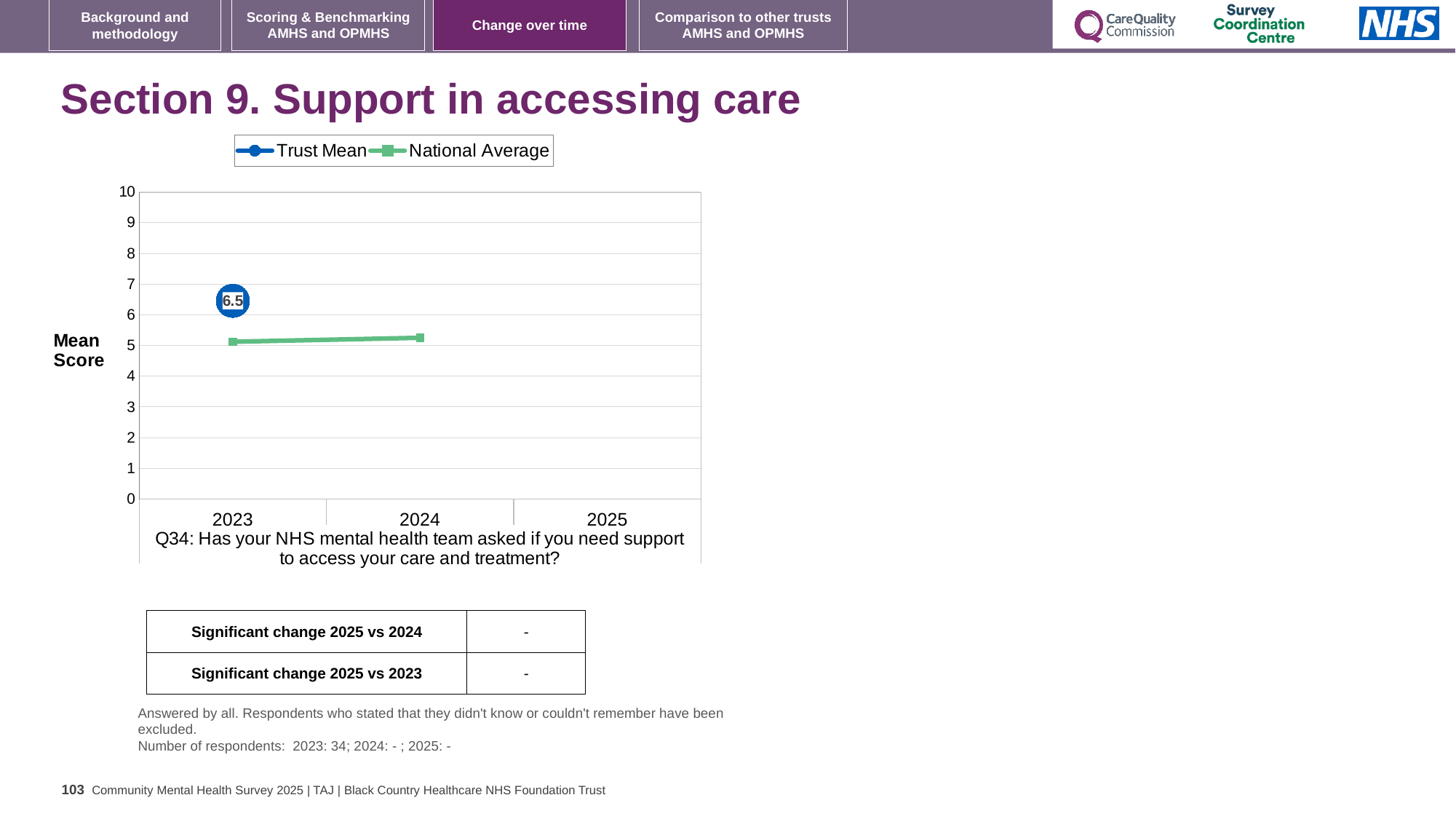
Is the Trust Mean value for 2023 greater or less than 6? greater Does the National Average rise or fall from 2023 to 2024? Rises What is the highest value shown on the y axis? 10 How many years are shown on the x axis? 3 Is the National Average value for 2023 greater or less than 6? less In 2023, which is larger: the Trust Mean or the National Average? Trust Mean What is the Trust Mean value for 2023? 6.5 What kind of chart is shown on the slide? Line chart Is the National Average value for 2024 greater or less than 5? greater How many series does the legend list? 2 What is the label on the y axis? Mean Score Which series is drawn in green? National Average